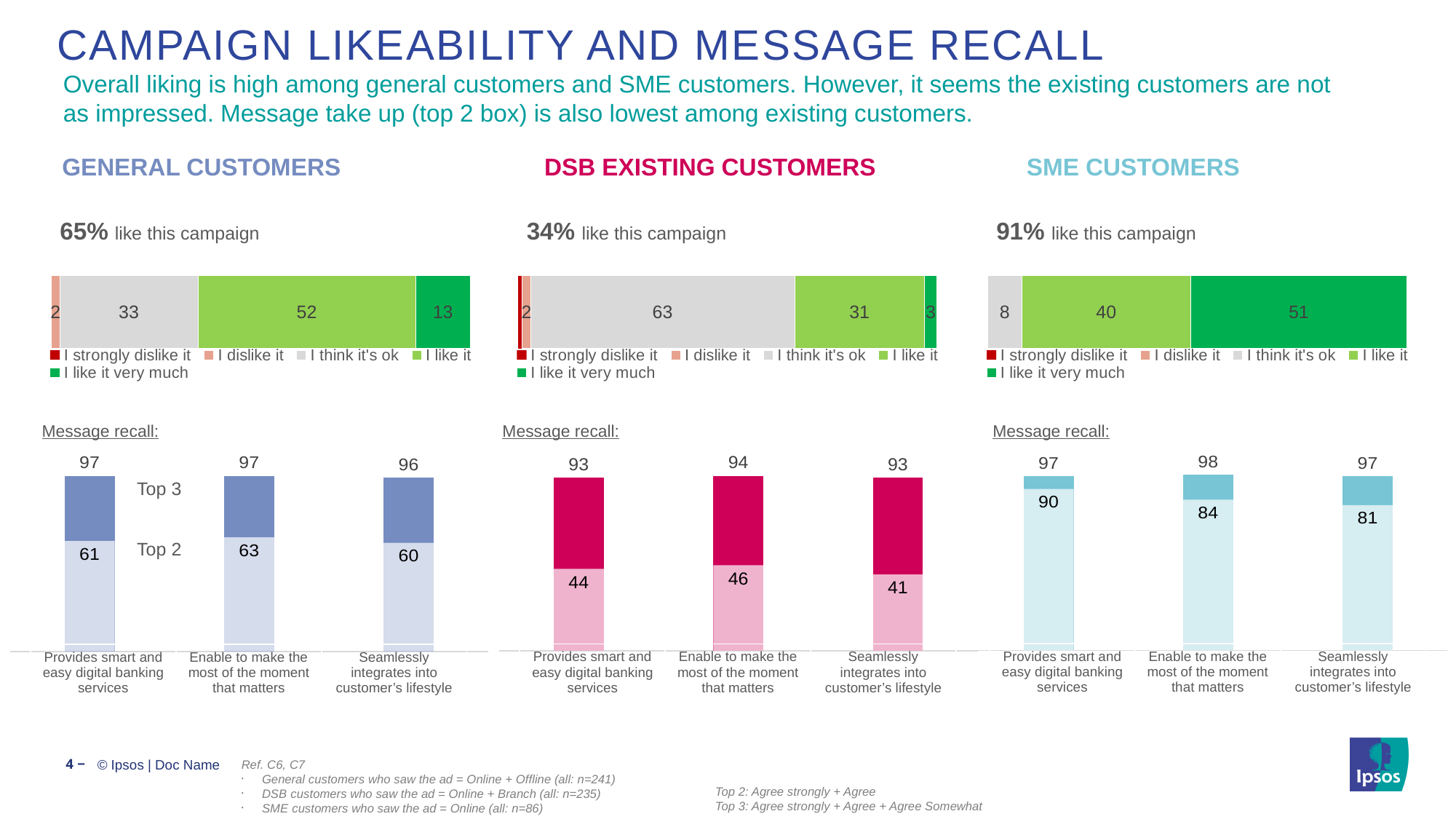
In the DSB Existing Customers message recall chart, what is the Top 2 value for "Seamlessly integrates into customer's lifestyle"? 41 In the SME Customers likeability bar, what value is shown for "I like it very much"? 51 In the DSB Existing Customers likeability bar, which response category has the largest value? I think it's ok In the DSB Existing Customers likeability bar, what value is shown for "I think it's ok"? 63 In the SME Customers message recall chart, what is the Top 3 value for "Enable to make the most of the moment that matters"? 98 In the SME Customers message recall chart, which message has the lowest Top 2 value? Seamlessly integrates into customer's lifestyle In the General Customers message recall chart, what is the Top 2 value for "Enable to make the most of the moment that matters"? 63 How many message categories are shown in the General Customers message recall chart? 3 In the DSB Existing Customers message recall chart, which has the higher Top 2 value: "Provides smart and easy digital banking services" or "Enable to make the most of the moment that matters"? Enable to make the most of the moment that matters In the General Customers likeability bar, what percentage of respondents said "I like it"? 52 In the SME Customers message recall chart, what is the difference between the Top 2 values for "Provides smart and easy digital banking services" and "Seamlessly integrates into customer's lifestyle"? 9 How many response categories does the legend of the General Customers likeability chart list? 5